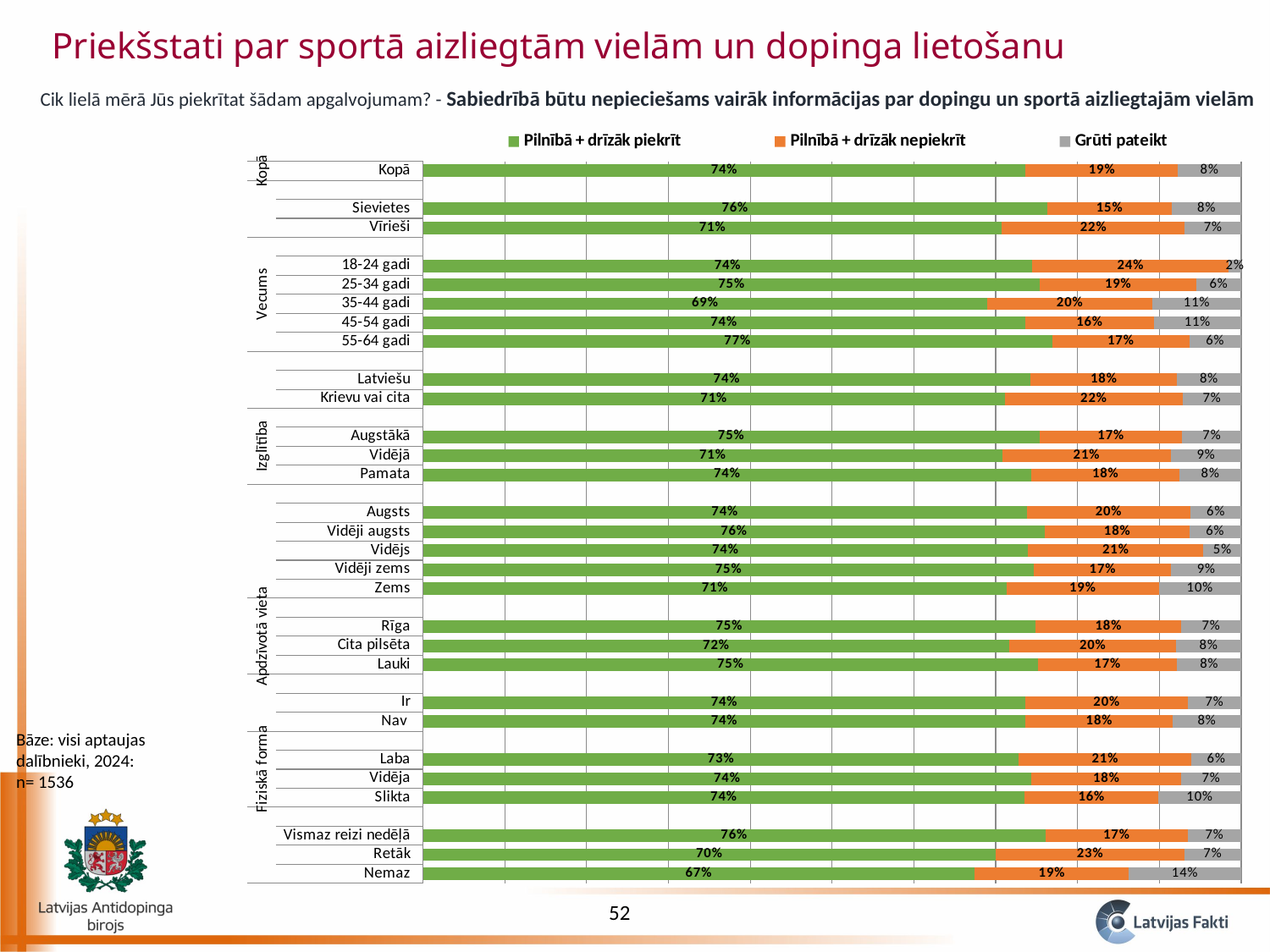
Which category has the highest 'Pilnībā + drīzāk piekrīt' value? 55-64 gadi How many categories are plotted in the chart? 29 What percentage of the 'Kopā' group falls under 'Pilnībā + drīzāk piekrīt'? 74% What is the 'Grūti pateikt' value for the 'Nemaz' category? 14% Which has a larger 'Pilnībā + drīzāk nepiekrīt' value, 'Retāk' or 'Vismaz reizi nedēļā'? Retāk What is the difference in percentage points between the 'Pilnībā + drīzāk piekrīt' values for 'Sievietes' and 'Vīrieši'? 5 percentage points What is the total of the stacked bar for 'Vīrieši'? 100% How many series does the legend list? 3 What is the 'Pilnībā + drīzāk nepiekrīt' value for '18-24 gadi'? 24% Which colour represents the 'Grūti pateikt' series? Grey What kind of chart is shown on the slide? Stacked bar chart Which category has the lowest 'Pilnībā + drīzāk piekrīt' value? Nemaz